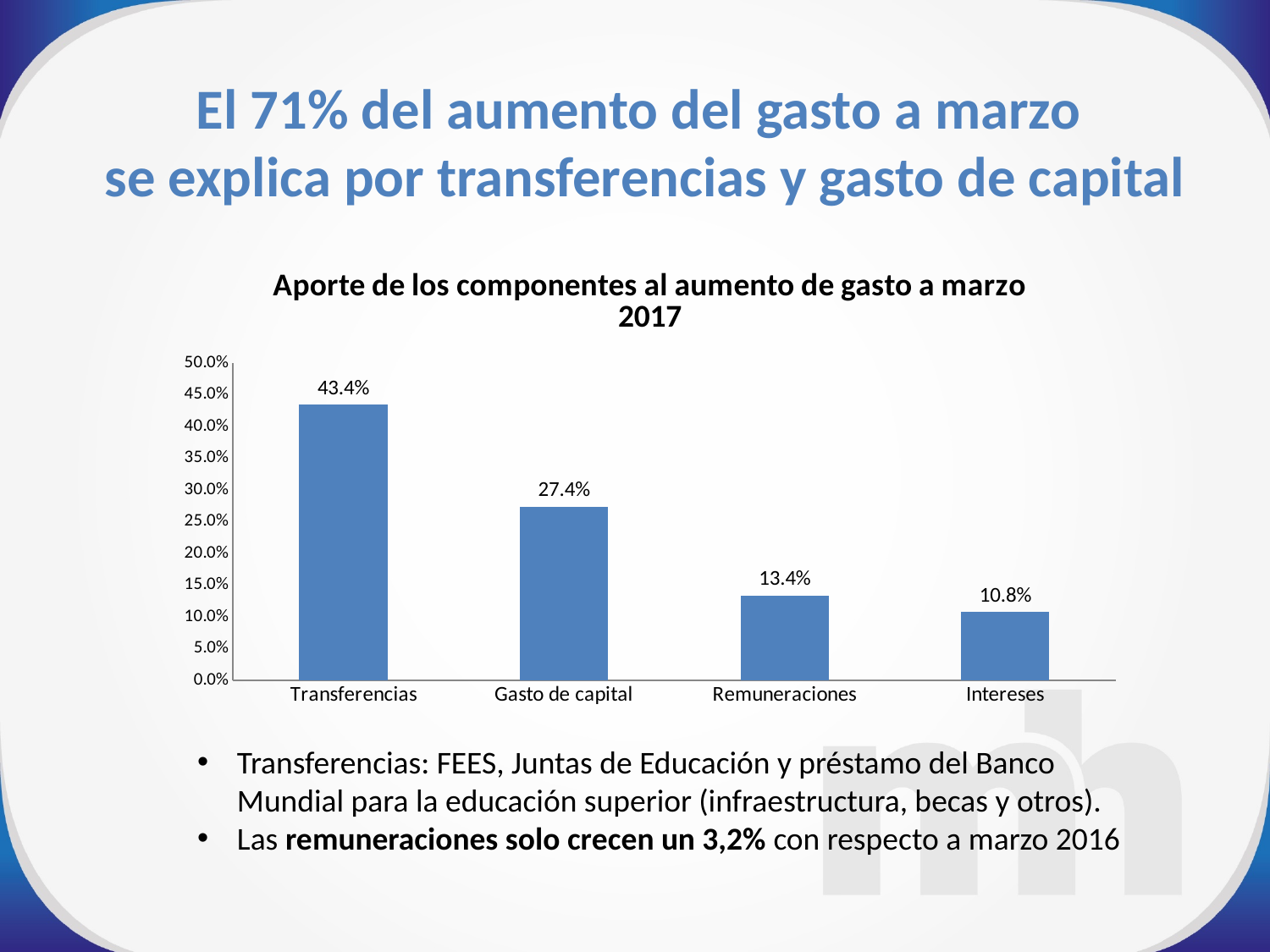
What is the value for Gasto de capital? 27.4% What is the value for Remuneraciones? 13.4% What is the difference between the values for Transferencias and Gasto de capital? 16.0% How many categories are shown on the x axis? 4 What is the title of the chart? Aporte de los componentes al aumento de gasto a marzo 2017 Which is larger, the value for Remuneraciones or the value for Intereses? Remuneraciones What is the value for Intereses? 10.8% Which category has the lowest value? Intereses Is the value for Gasto de capital greater or less than 25.0%? greater Which category has the highest value? Transferencias What is the value for Transferencias? 43.4% What kind of chart is shown on the slide? Bar chart